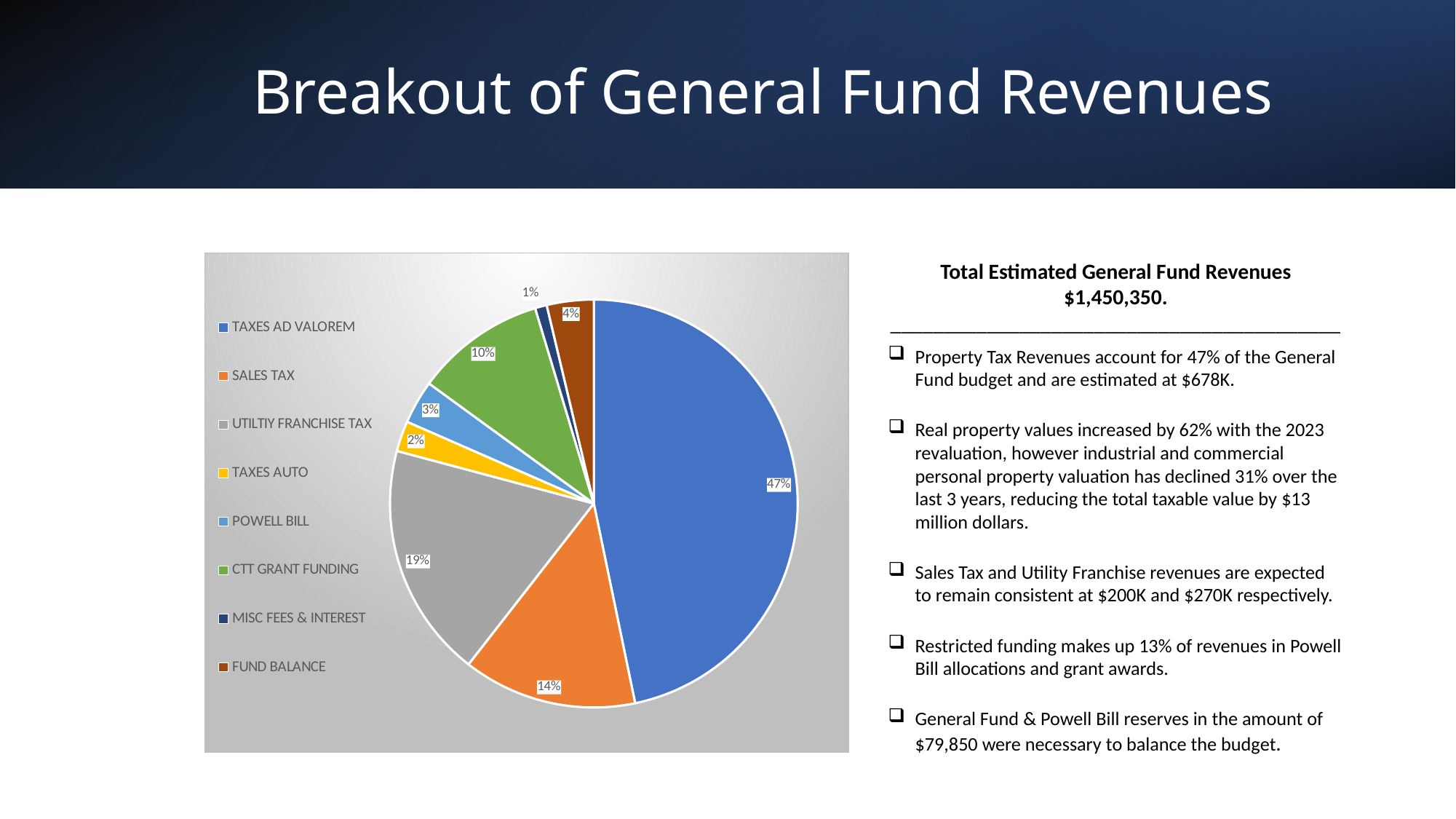
What percentage of the pie is UTILTIY FRANCHISE TAX? 19% Which category has the smallest slice of the pie? MISC FEES & INTEREST What share of General Fund revenues comes from TAXES AD VALOREM? 47% What is the difference in percentage points between UTILTIY FRANCHISE TAX and SALES TAX? 5 What kind of chart is shown on the slide? Pie chart What percentage of the pie is SALES TAX? 14% Which category has the largest slice of the pie? TAXES AD VALOREM What percentage is shown for FUND BALANCE? 4% How many categories does the legend list? 8 What share does CTT GRANT FUNDING represent? 10% What colour is the TAXES AUTO slice? Yellow Which is larger, POWELL BILL or TAXES AUTO? POWELL BILL